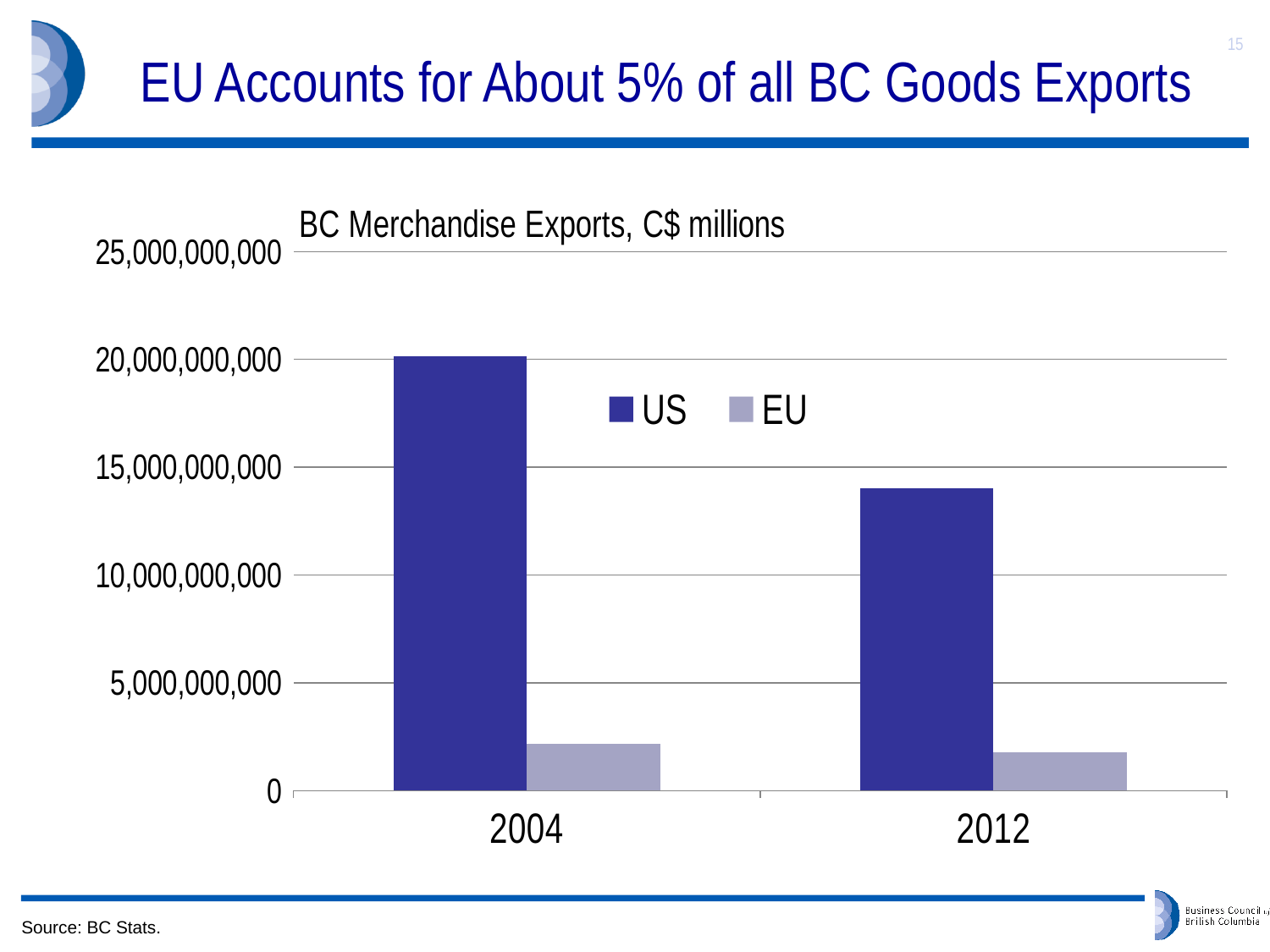
Is the US value for 2012 greater or less than 15,000,000,000? less How many series does the legend list? 2 Which series has the higher value in 2012, US or EU? US Which year has the higher US value, 2004 or 2012? 2004 What kind of chart is shown on the slide? bar chart What is the title of the chart? BC Merchandise Exports, C$ millions Do US exports rise or fall from 2004 to 2012? fall How many years are shown on the x axis? 2 What is the source cited for the chart? BC Stats Is the EU value for 2004 greater or less than 5,000,000,000? less Which series has the higher value in 2004, US or EU? US